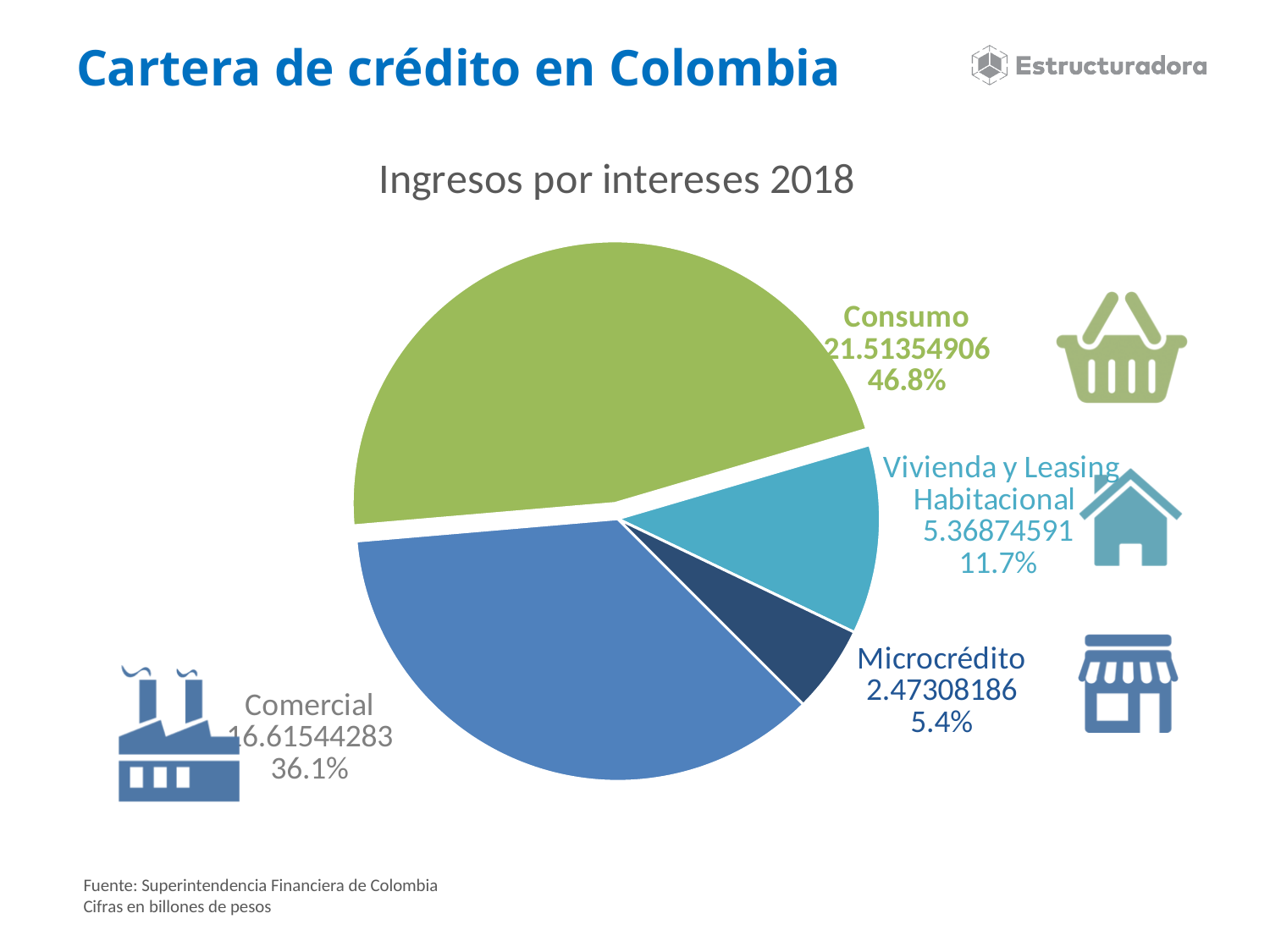
How many slices does the pie chart have? 4 What is the title of the chart? Ingresos por intereses 2018 What percentage share does Vivienda y Leasing Habitacional have? 11.7% What percentage share does Comercial have in the pie chart? 36.1% Which is larger, the share for Vivienda y Leasing Habitacional or the share for Microcrédito? Vivienda y Leasing Habitacional What is the value shown for Microcrédito? 2.47308186 Which category has the largest slice of the pie? Consumo What type of chart is shown on the slide? pie chart Which category has the smallest slice of the pie? Microcrédito What is the value shown for Consumo? 21.51354906 What is the difference in percentage points between the Consumo share and the Comercial share? 10.7 What percentage share does Consumo have in the pie chart? 46.8%